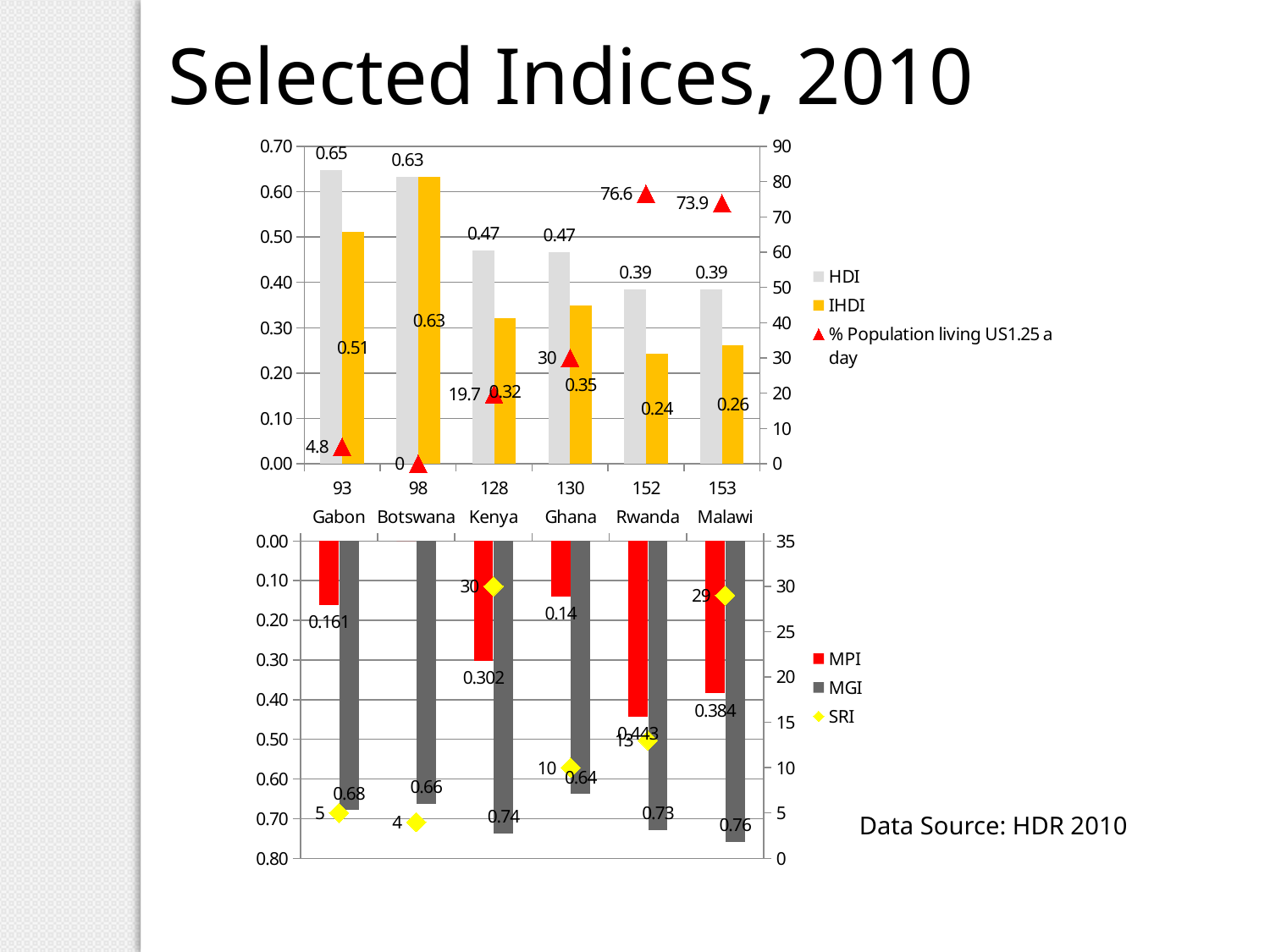
In the bottom chart, what is the MPI value for Rwanda? 0.443 In the bottom chart, which country has the lowest SRI value? Botswana In the top chart, what is the % Population living US1.25 a day value for Rwanda? 76.6 In the bottom chart, what is the MGI value for Malawi? 0.76 In the top chart, what is the difference between the HDI and IHDI values for Gabon? 0.14 In the top chart, which country has the highest % Population living US1.25 a day? Rwanda In the bottom chart, is the MGI value for Ghana larger or smaller than the MGI value for Kenya? smaller In the bottom chart, what is the SRI value for Kenya? 30 In the top chart, how many series does the legend list? 3 In the top chart, what is the IHDI value for Rwanda? 0.24 In the top chart, which country has the lowest IHDI value? Rwanda In the top chart, what is the HDI value for Gabon? 0.65